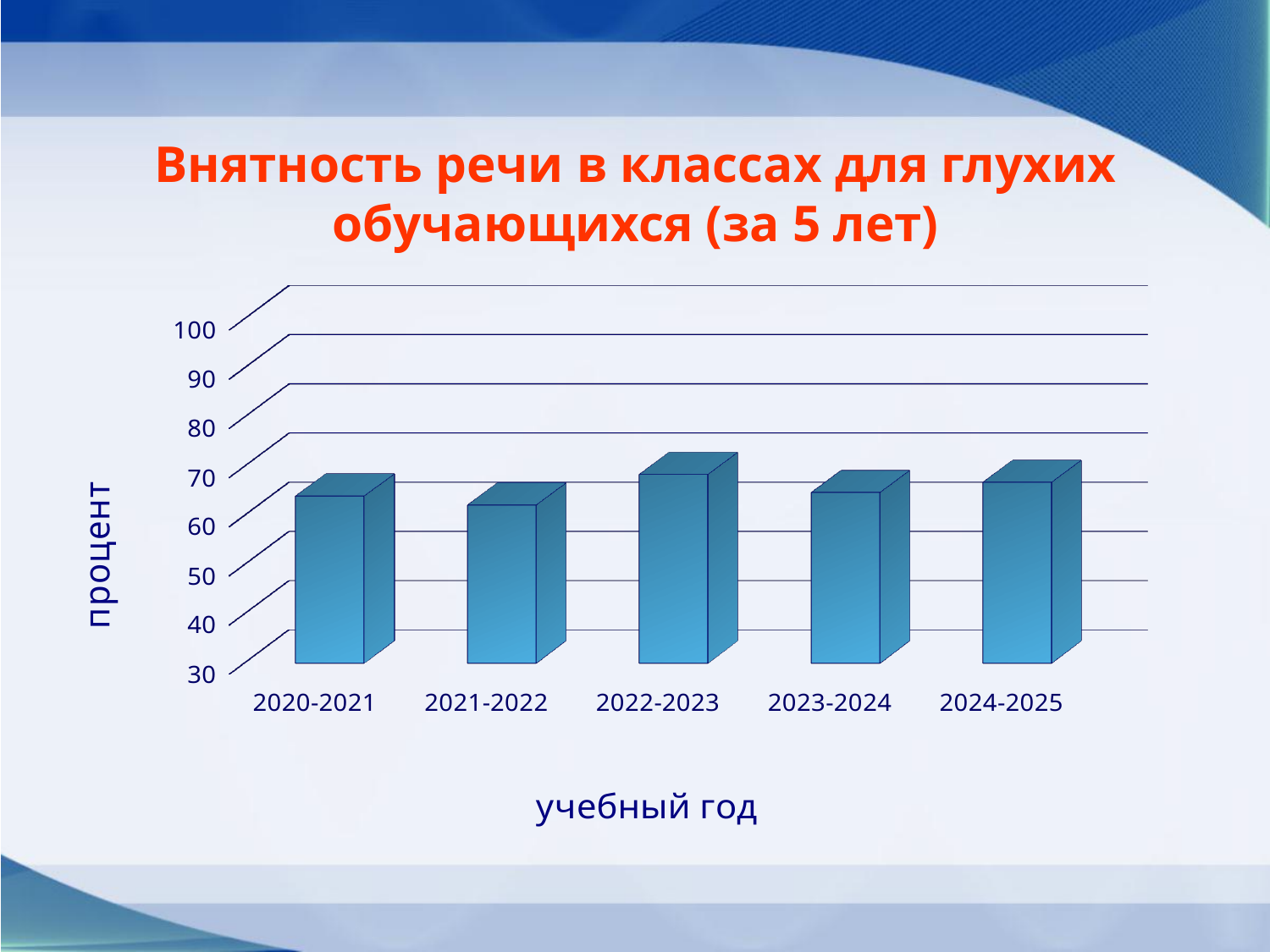
Which academic year has the highest value in the chart? 2022-2023 Which is larger, the value for 2022-2023 or the value for 2021-2022? 2022-2023 Which academic year has the lowest value in the chart? 2021-2022 What is the title of the chart? Внятность речи в классах для глухих обучающихся (за 5 лет) Is the value for 2022-2023 greater or less than 80? less Does the value rise or fall from 2021-2022 to 2022-2023? rise What kind of chart is shown on the slide? bar chart How many academic years are shown on the x axis of the chart? 5 Is the value for 2020-2021 greater or less than 70? less What is the label of the vertical axis of the chart? процент Is the value for 2024-2025 greater or less than 50? greater